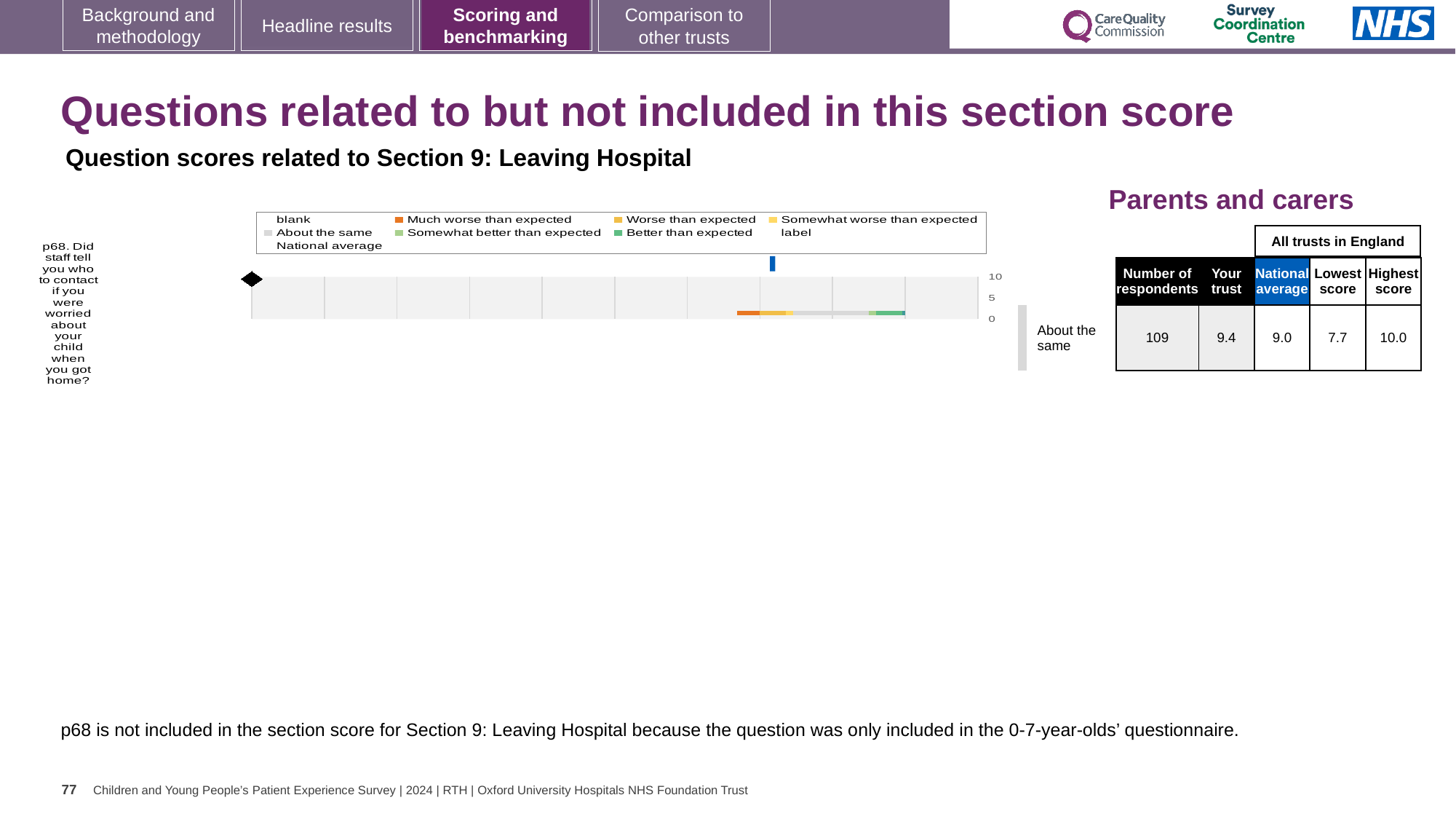
What kind of chart is shown on the slide? Bar chart What is the national average score for p68? 9.0 What is the lowest score among all trusts in England for p68? 7.7 What colour represents 'Much worse than expected' in the legend? Orange What is the difference between the highest and lowest scores for p68? 2.3 Which question is plotted in the chart? p68. Did staff tell you who to contact if you were worried about your child when you got home? What is the highest score among all trusts in England for p68? 10.0 How many survey questions are plotted in the chart? 1 Which is higher for p68, the 'Your trust' score or the national average? Your trust What is the 'Your trust' score for p68? 9.4 How many entries does the chart legend list? 9 How many respondents answered p68? 109